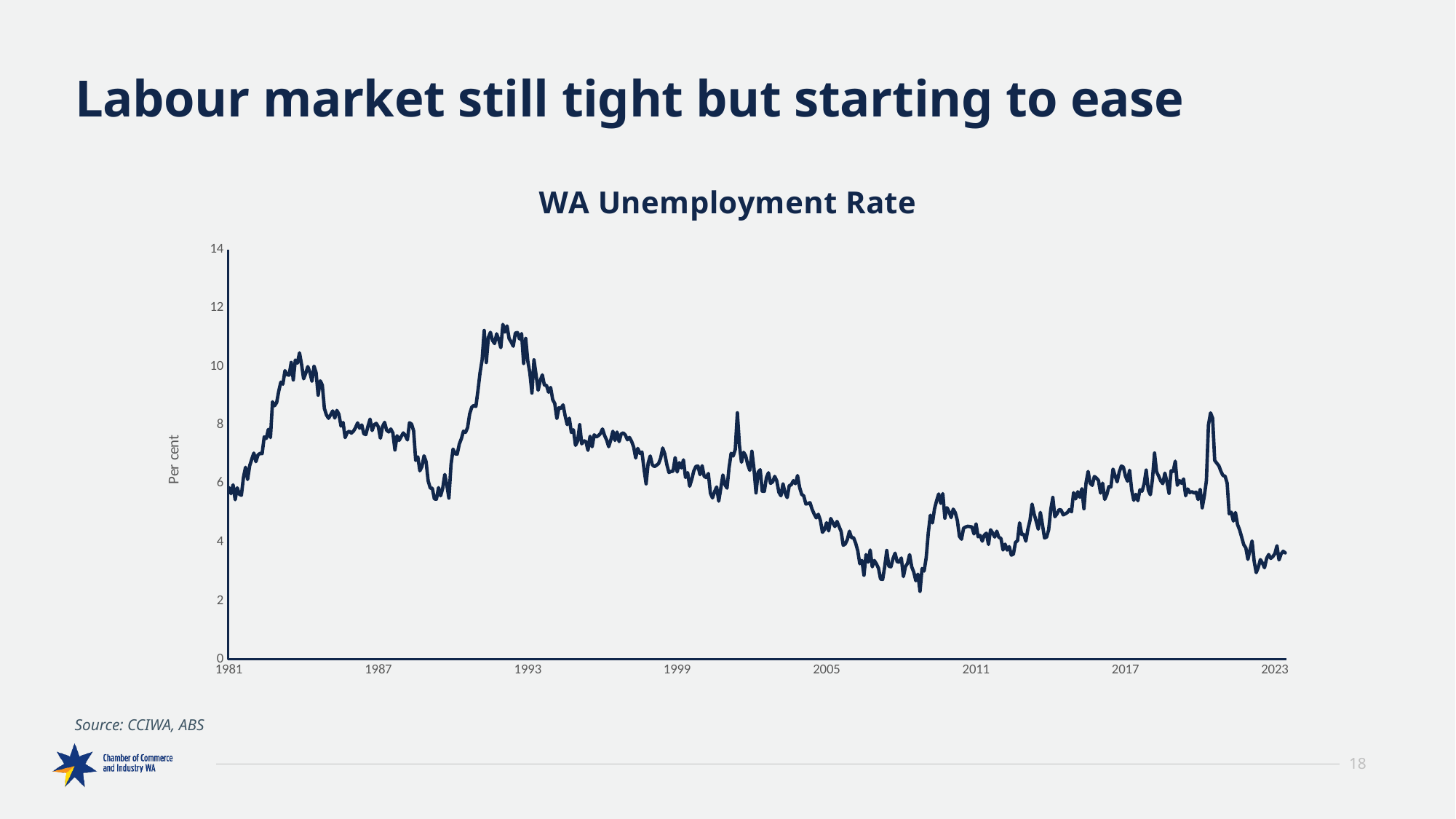
How many data series are plotted on the chart? 1 What kind of chart is shown on the slide? Line chart Is the WA unemployment rate around 2005 greater or less than 6? less How many year labels are shown along the x axis? 8 What is the label on the vertical axis of the chart? Per cent Which is higher: the peak in the WA unemployment rate in the early 1990s or the peak in the mid-1980s? The early 1990s peak In which decade does the WA unemployment rate reach its highest value on the chart? 1990s Is the WA unemployment rate at its early-1990s peak greater or less than 10? greater Does the WA unemployment rate generally rise or fall between 1993 and 2008? Fall What is the title of the chart? WA Unemployment Rate Is the WA unemployment rate around 1987 greater or less than 6? greater